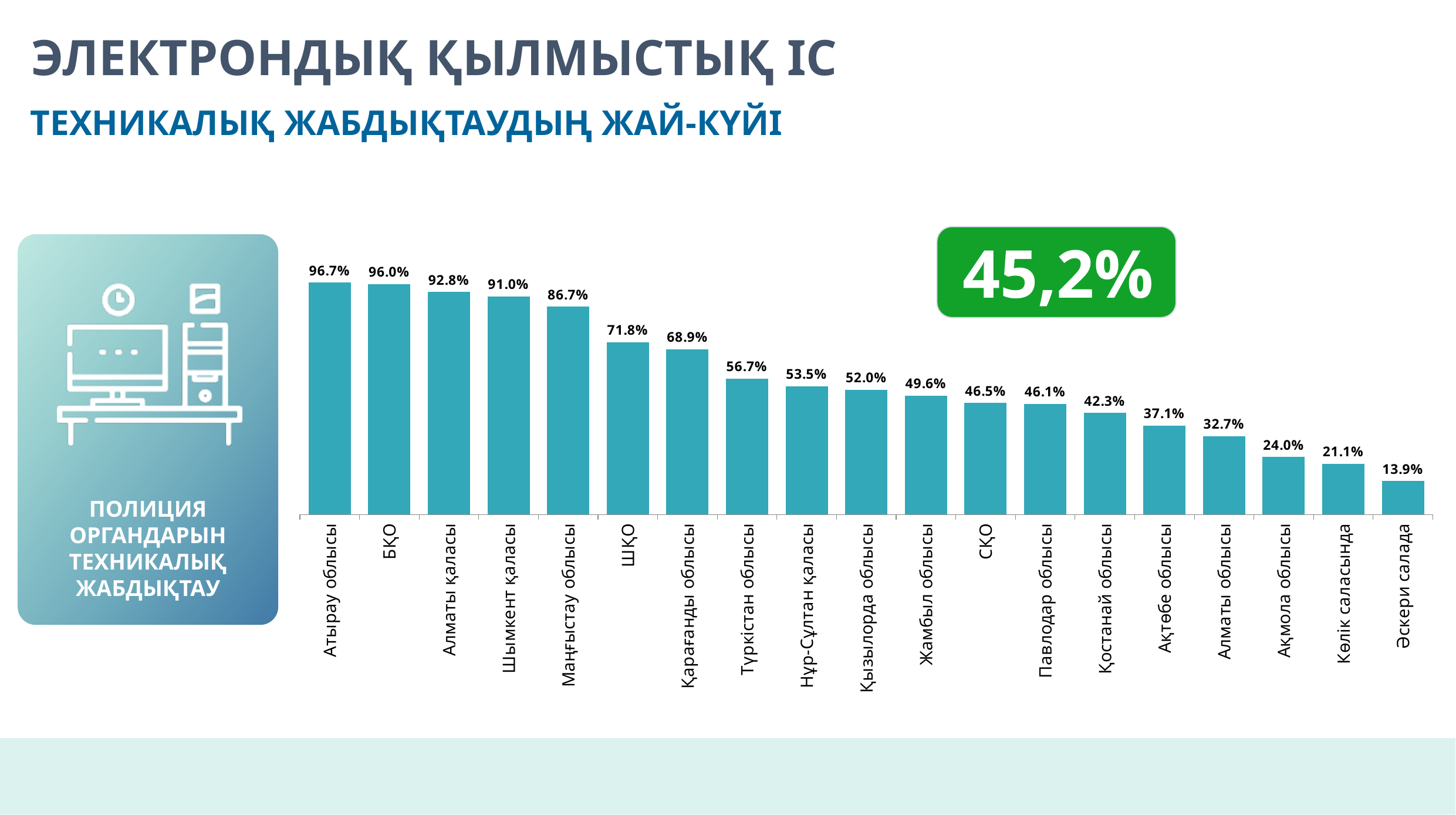
Which is larger, the value for Қарағанды облысы or the value for Түркістан облысы? Қарағанды облысы Which category has the lowest value in the chart? Әскери салада What is the value for Ақмола облысы? 24.0% What is the difference between the values for Атырау облысы and Әскери салада? 82.8 percentage points What is the value for ШҚО? 71.8% What is the value for Нұр-Сұлтан қаласы? 53.5% How many categories (bars) does the chart show? 19 Which category has the highest value in the chart? Атырау облысы What kind of chart is shown on the slide? bar chart Do the values rise or fall from left to right along the x axis? fall What percentage is shown in the green box above the chart? 45,2% What is the value for Маңғыстау облысы? 86.7%